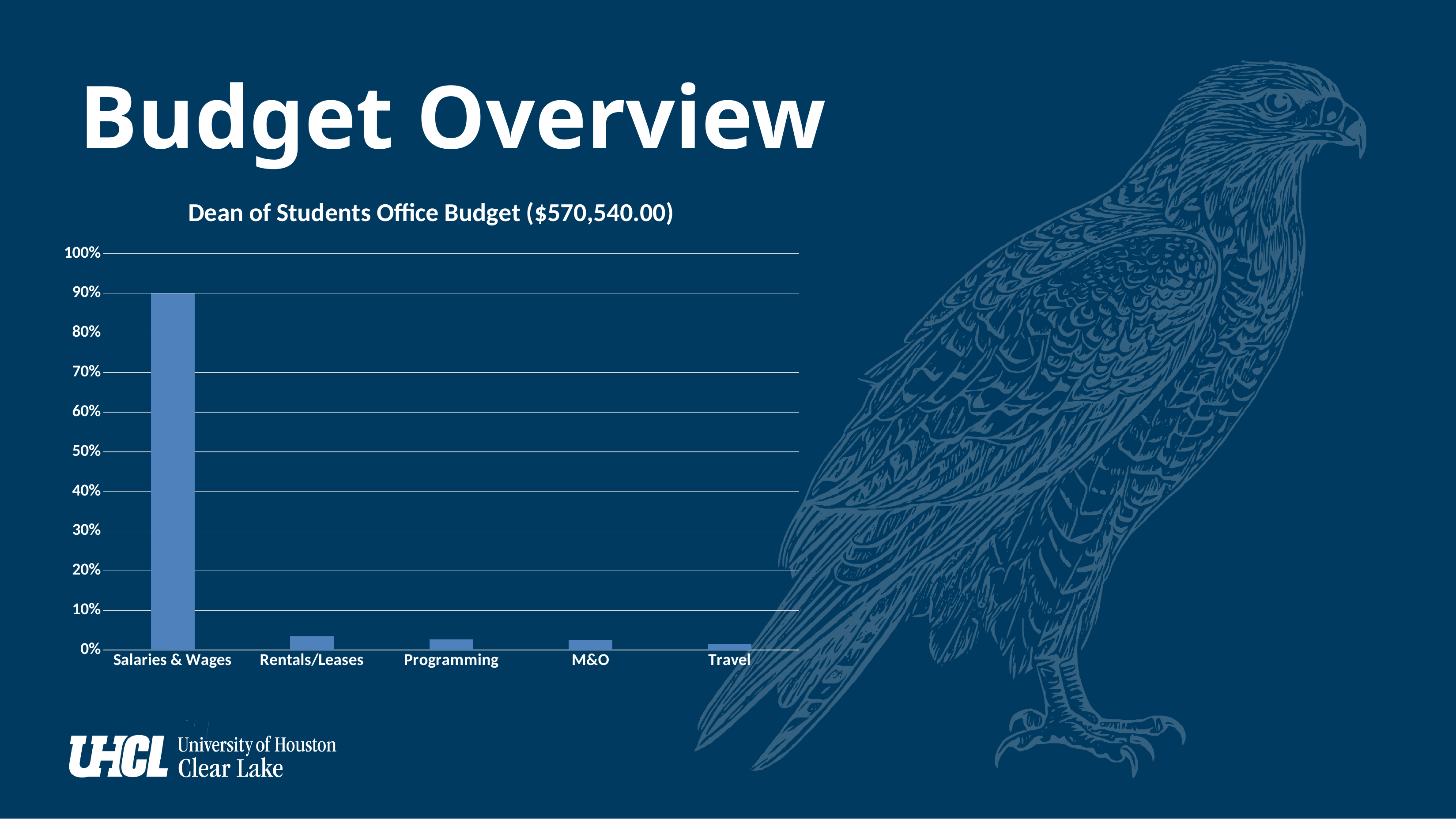
Is the value for Rentals/Leases greater or less than 10%? less What is the title of the chart? Dean of Students Office Budget ($570,540.00) Which is larger, the value for Rentals/Leases or the value for Travel? Rentals/Leases Is the value for M&O greater or less than 20%? less What kind of chart is shown on the slide? bar chart How many budget categories are shown on the x axis? 5 Is the value for Salaries & Wages greater or less than 80%? greater Which category has the highest share of the budget? Salaries & Wages What total budget amount is shown in the chart title? $570,540.00 Which is larger, the value for Salaries & Wages or the value for Programming? Salaries & Wages Which category has the lowest share of the budget? Travel